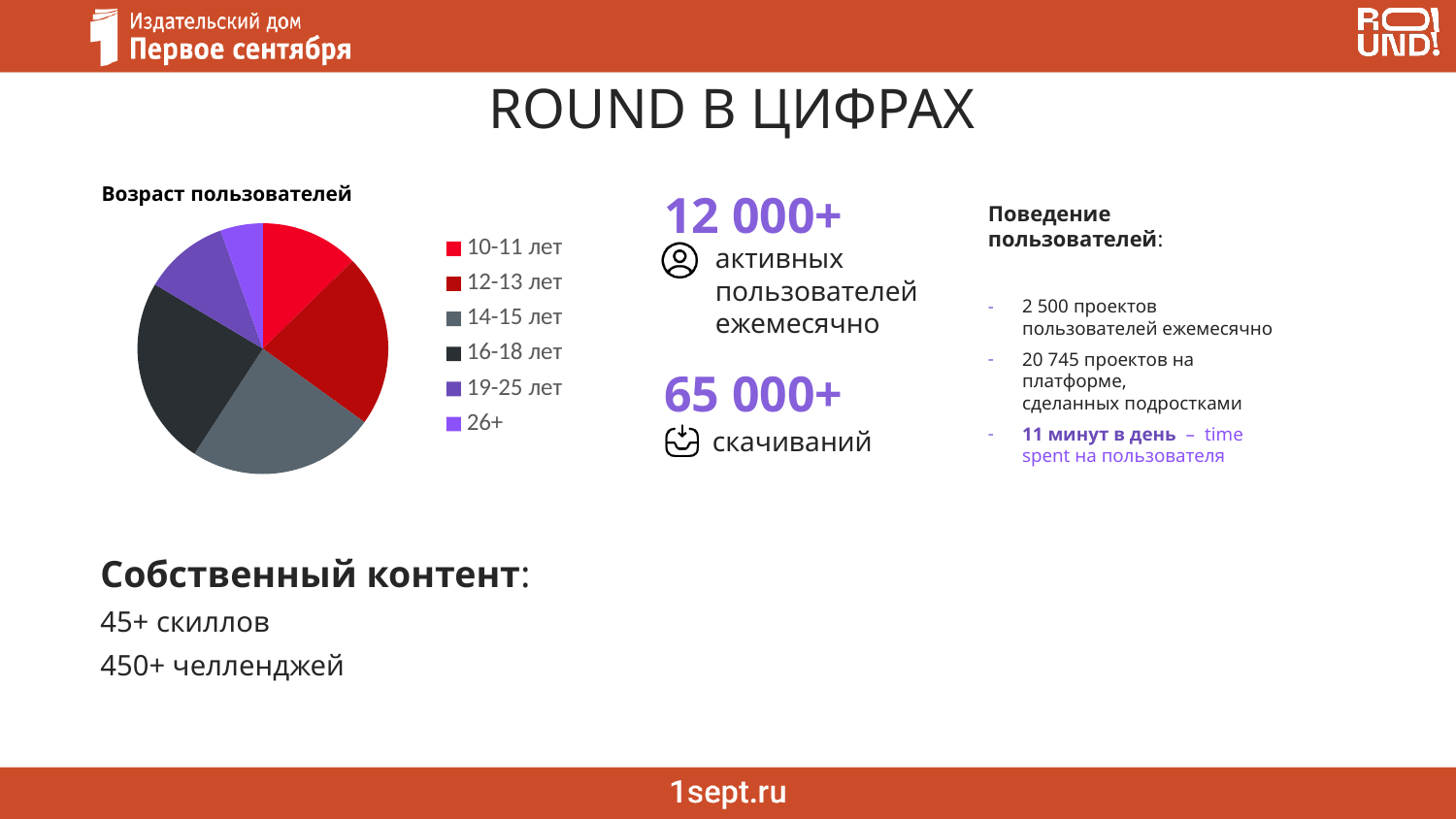
Which age category has the smallest slice in the pie chart "Возраст пользователей"? 26+ What is the title of the pie chart on the slide? Возраст пользователей Which age category is listed first in the legend of the pie chart "Возраст пользователей"? 10-11 лет In the pie chart "Возраст пользователей", which slice is larger: 14-15 лет or 19-25 лет? 14-15 лет What kind of chart is shown under the heading "Возраст пользователей"? pie chart In the pie chart "Возраст пользователей", which slice is larger: 14-15 лет or 26+? 14-15 лет In the pie chart "Возраст пользователей", which slice is larger: 16-18 лет or 19-25 лет? 16-18 лет How many entries does the legend of the pie chart "Возраст пользователей" list? 6 How many age categories does the pie chart "Возраст пользователей" show? 6